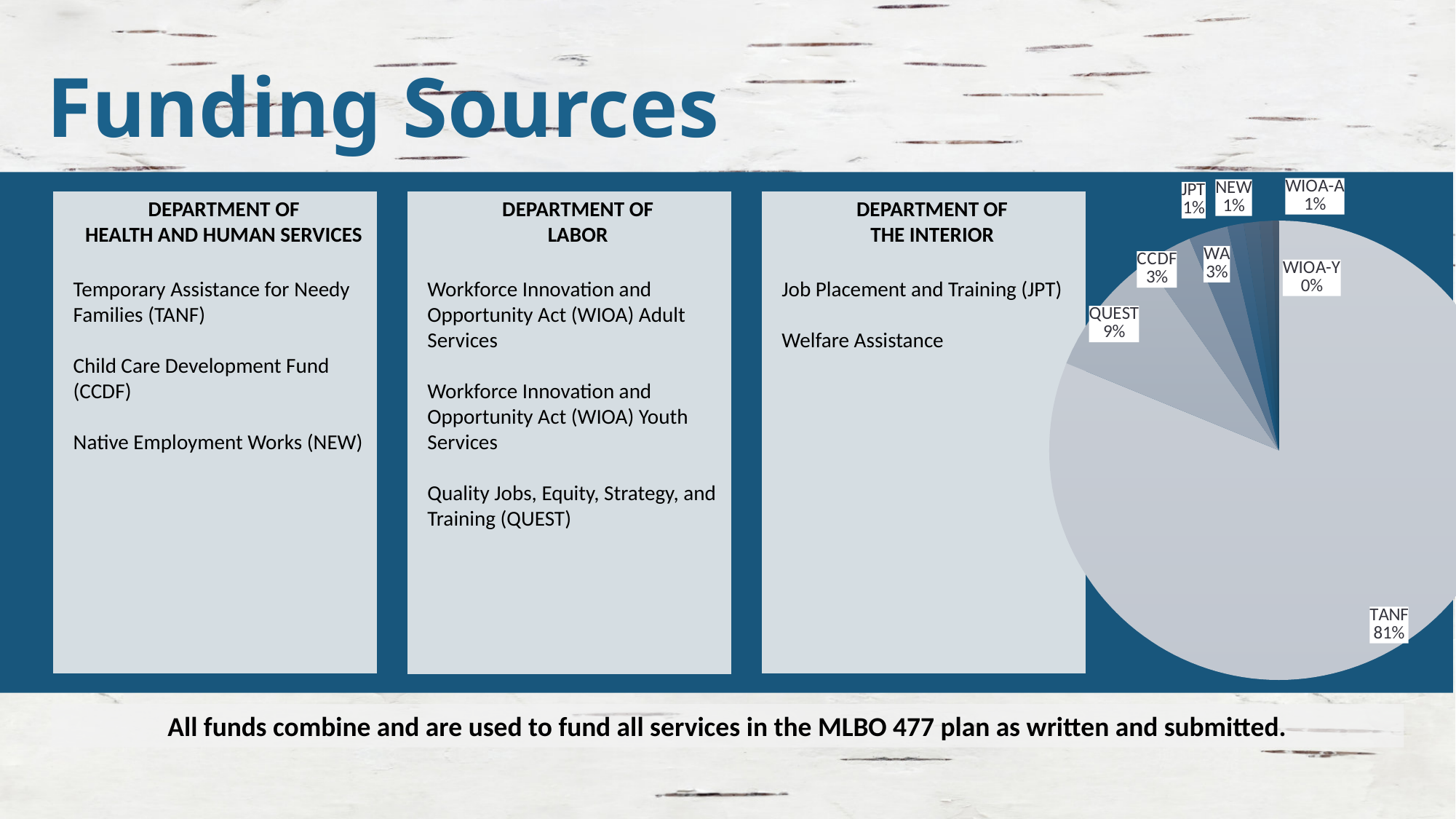
What is the combined share of JPT, NEW and WIOA-A? 3% Which funding source has the smallest slice of the pie? WIOA-Y What share of the pie does WIOA-Y represent? 0% What share of the pie does QUEST represent? 9% Which funding source has the largest slice of the pie? TANF What share of the pie does TANF represent? 81% Which is larger, the share for QUEST or the share for CCDF? QUEST What kind of chart is shown on the slide? pie chart What share of the pie does CCDF represent? 3% What is the difference in percentage points between TANF and QUEST? 72 How many slices are labelled in the pie chart? 8 What share of the pie does WA represent? 3%